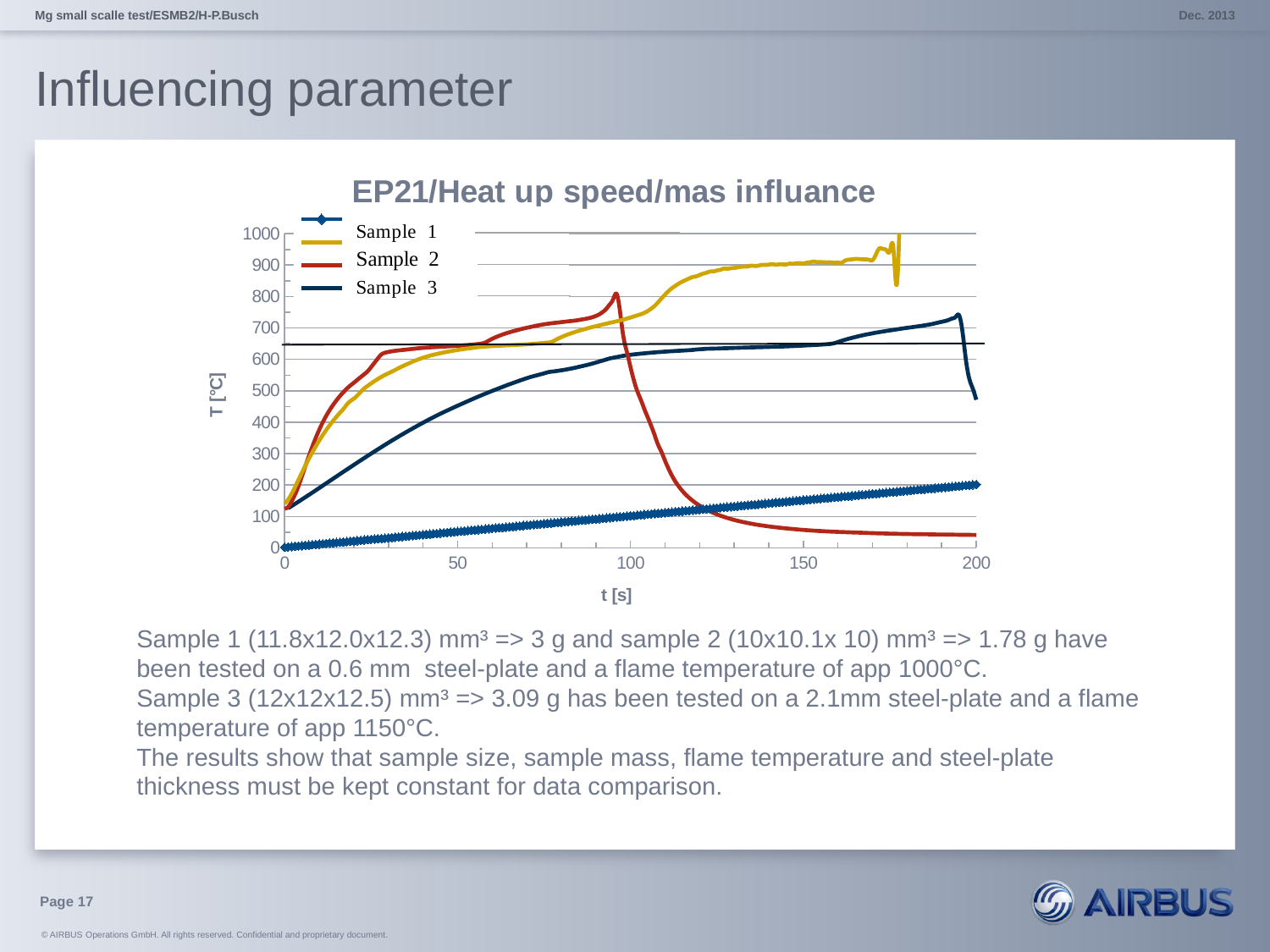
What is the title of the chart? EP21/Heat up speed/mas influance Does the Sample 1 line rise or fall as t increases from 0 to 200 s? rise How many series does the legend of the chart list? 3 Is the value for Sample 1 at t = 200 s greater or less than 400? less Is the value for Sample 1 at t = 100 s greater or less than 300? less What kind of chart is shown on the slide? line chart What is the label of the x axis of the chart? t [s] Is the value for Sample 1 at t = 0 s greater or less than 100? less What is the highest tick value shown on the y axis of the chart? 1000